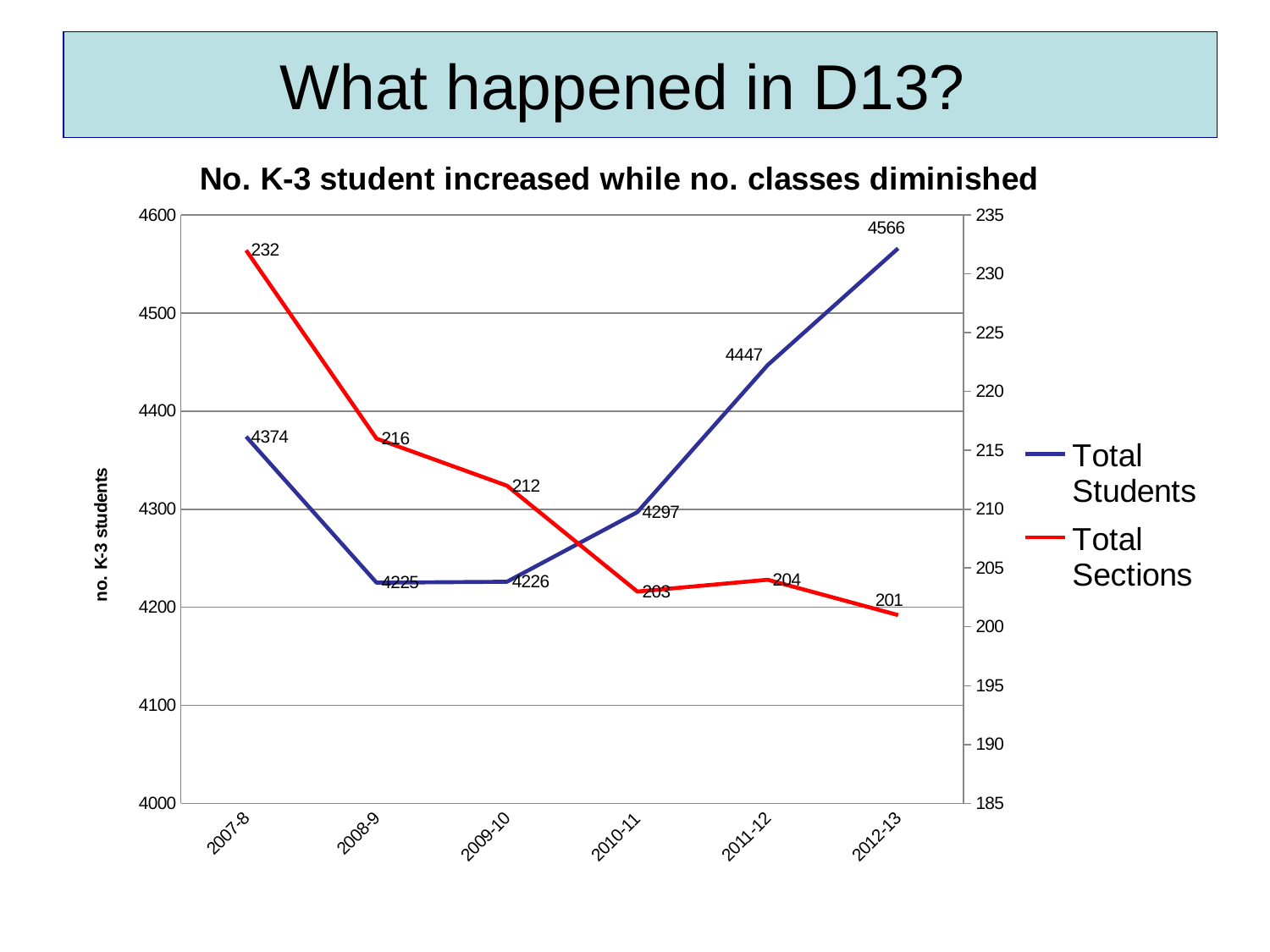
How many series does the legend list? 2 What is the Total Sections value for 2007-8? 232 What is the Total Sections value for 2011-12? 204 In which year is Total Sections lowest? 2012-13 What is the difference between Total Students in 2012-13 and 2007-8? 192 Which is larger, Total Students in 2008-9 or in 2010-11? 2010-11 How many years are shown on the x axis? 6 What is the difference between Total Sections in 2007-8 and 2012-13? 31 In which year is Total Students highest? 2012-13 What kind of chart is shown? line chart What is the Total Students value for 2012-13? 4566 What is the Total Students value for 2009-10? 4226